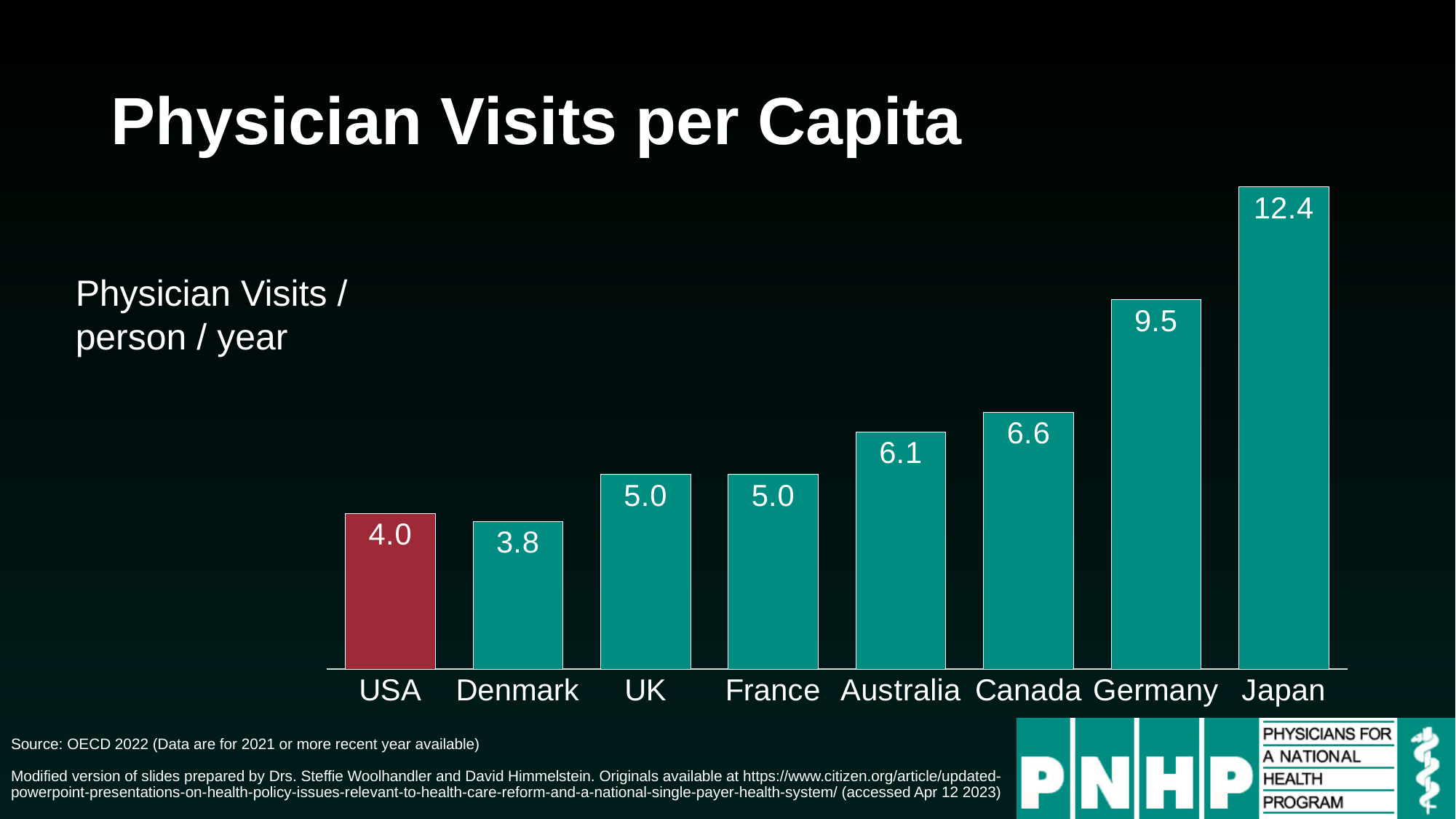
Which two countries have the same value of 5.0? UK and France Which country has the lowest number of physician visits per capita? Denmark What is the value for Japan? 12.4 Which has a larger value, Australia or Canada? Canada What kind of chart is shown on the slide? Bar chart What is the value for the USA? 4.0 What is the difference between the values for Japan and the USA? 8.4 Which bar is shown in a different colour (red) from the others? USA What is the difference between the values for Germany and Canada? 2.9 How many countries are shown in the chart? 8 Which country has the highest number of physician visits per capita? Japan What is the value for Germany? 9.5